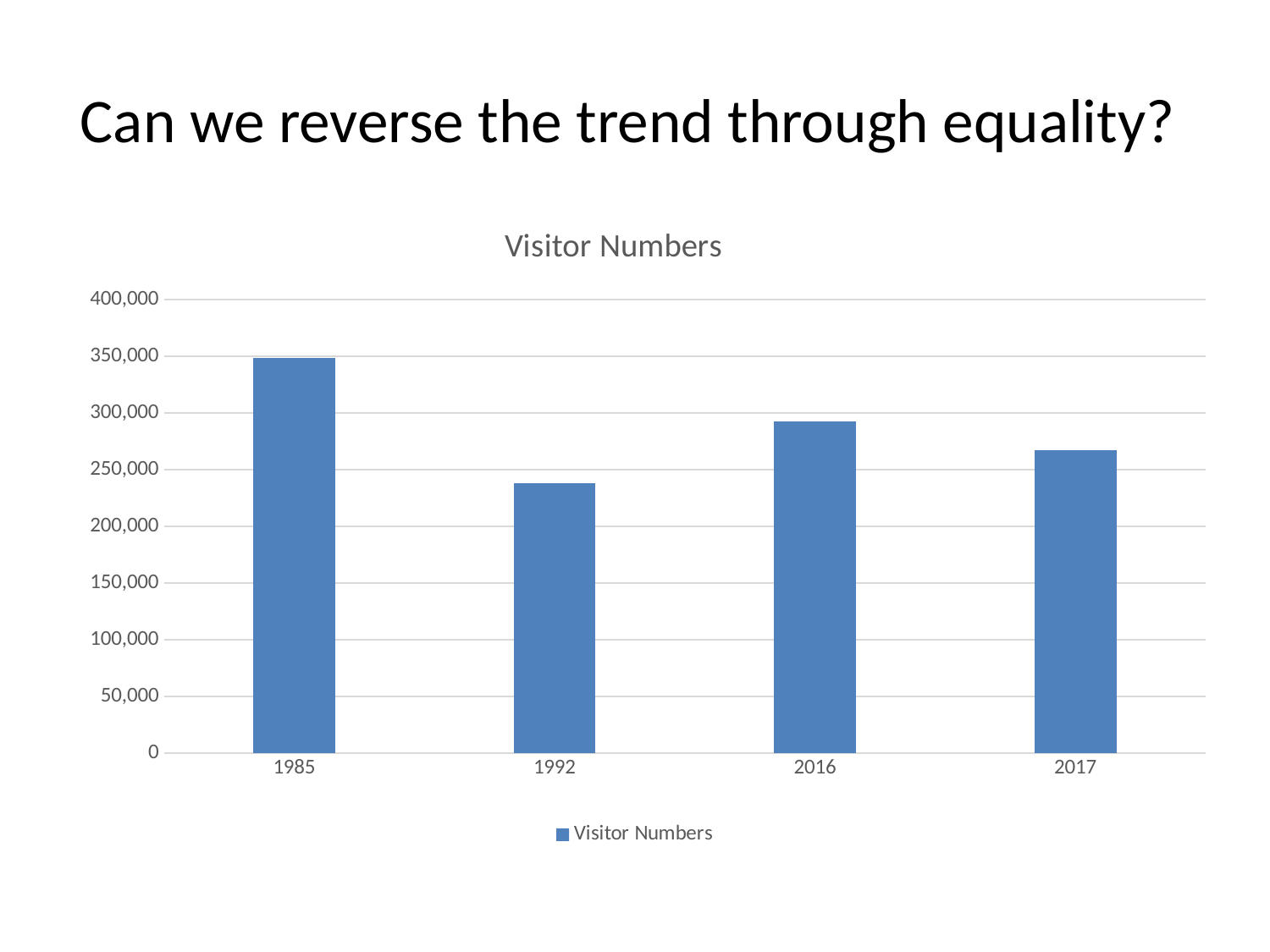
What is the title of the chart? Visitor Numbers Is the value for 2017 greater or less than 300,000? less Is the value for 1985 greater or less than 300,000? greater Which year has the lowest visitor numbers? 1992 Is the value for 1992 greater or less than 250,000? less Which year has higher visitor numbers, 1992 or 2017? 2017 What kind of chart is shown on the slide? bar chart How many years are shown on the x axis of the chart? 4 How many series does the legend list? 1 Which year has higher visitor numbers, 2016 or 2017? 2016 Which year has the highest visitor numbers? 1985